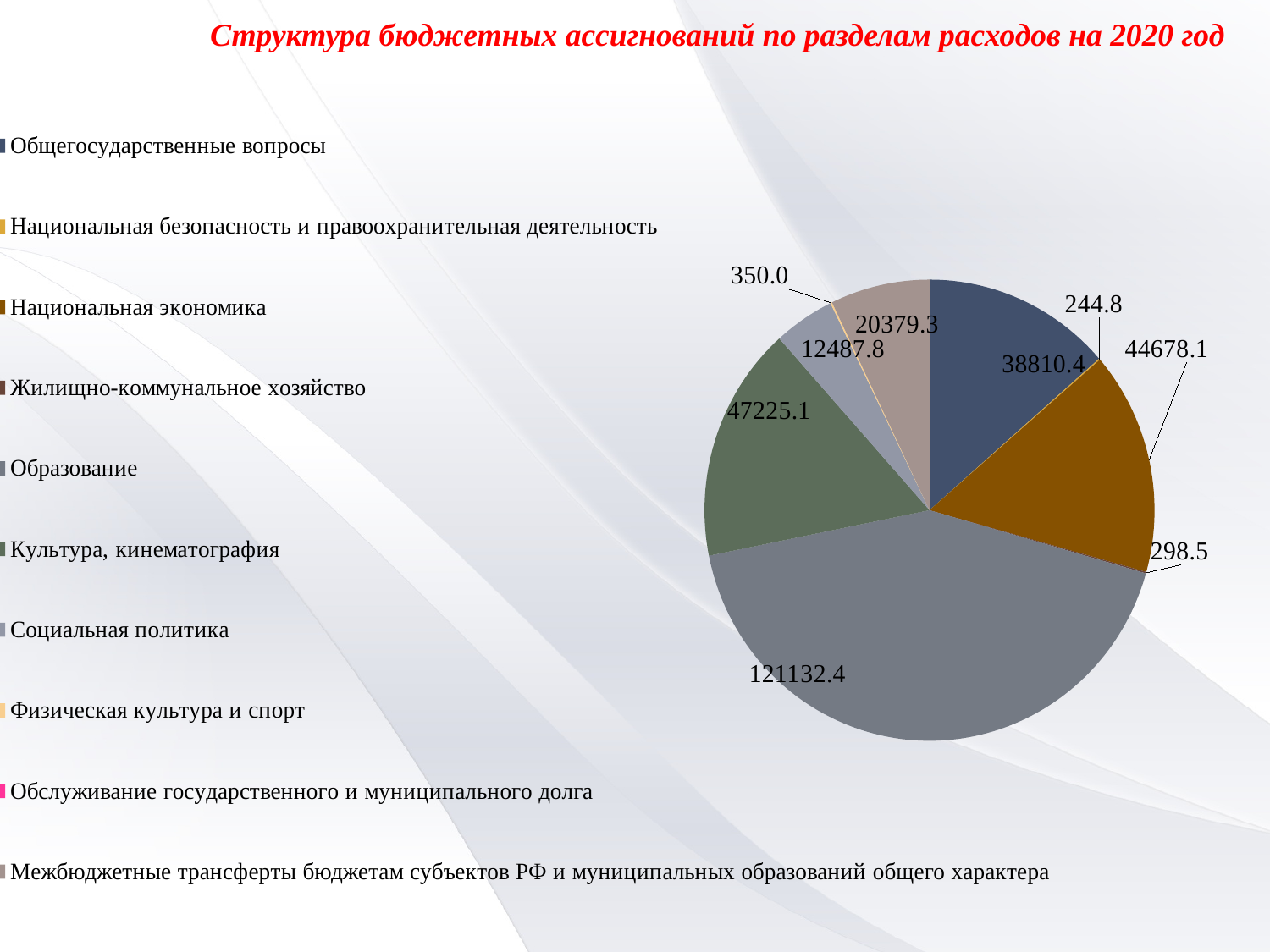
Which category has the largest slice of the pie? Образование Which is larger, the value for Образование or the value for Культура, кинематография? Образование What type of chart is shown on the slide? pie chart What is the value for Социальная политика? 12487.8 What is the value for Культура, кинематография? 47225.1 What is the value for Национальная экономика? 44678.1 What is the value for Физическая культура и спорт? 350.0 What is the value for Общегосударственные вопросы? 38810.4 How many categories does the legend list? 10 What is the difference between the values for Культура, кинематография and Национальная экономика? 2547.0 What is the value for Образование? 121132.4 What is the value for Межбюджетные трансферты бюджетам субъектов РФ и муниципальных образований общего характера? 20379.3